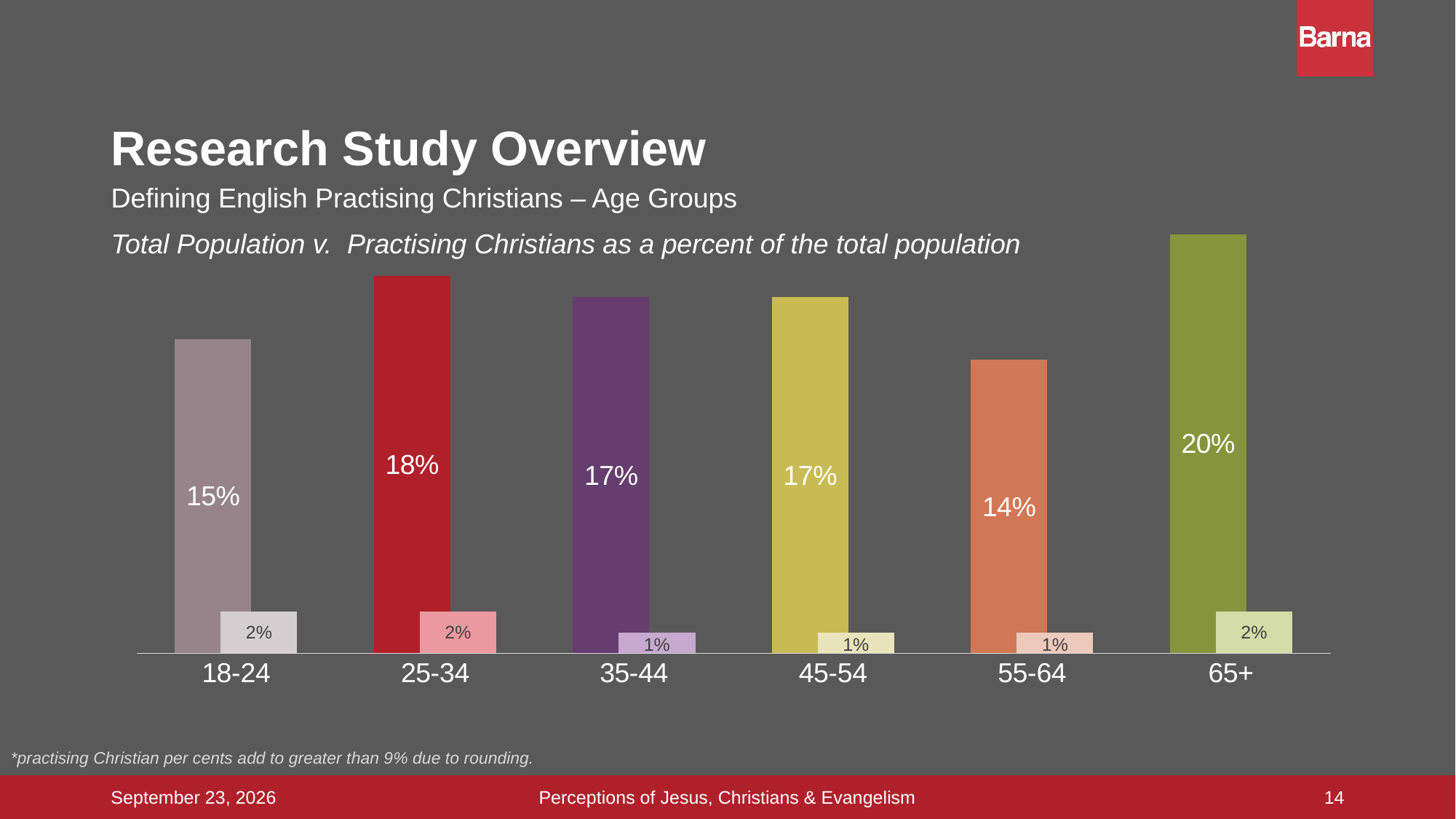
Which age group has the highest total population percentage? 65+ How many age groups are shown on the x axis? 6 What is the difference between the total population values for 65+ and 55-64? 6% What is the total population value for the 65+ age group? 20% What is the difference between the total population and practising Christians values for the 25-34 age group? 16% Which age group has the lowest total population percentage? 55-64 What is the total population value for the 55-64 age group? 14% What is the italic subtitle above the chart? Total Population v. Practising Christians as a percent of the total population What is the practising Christians value for the 35-44 age group? 1% Which is larger, the total population value for 18-24 or for 25-34? 25-34 What is the practising Christians value for the 18-24 age group? 2% What kind of chart is shown on the slide? Bar chart